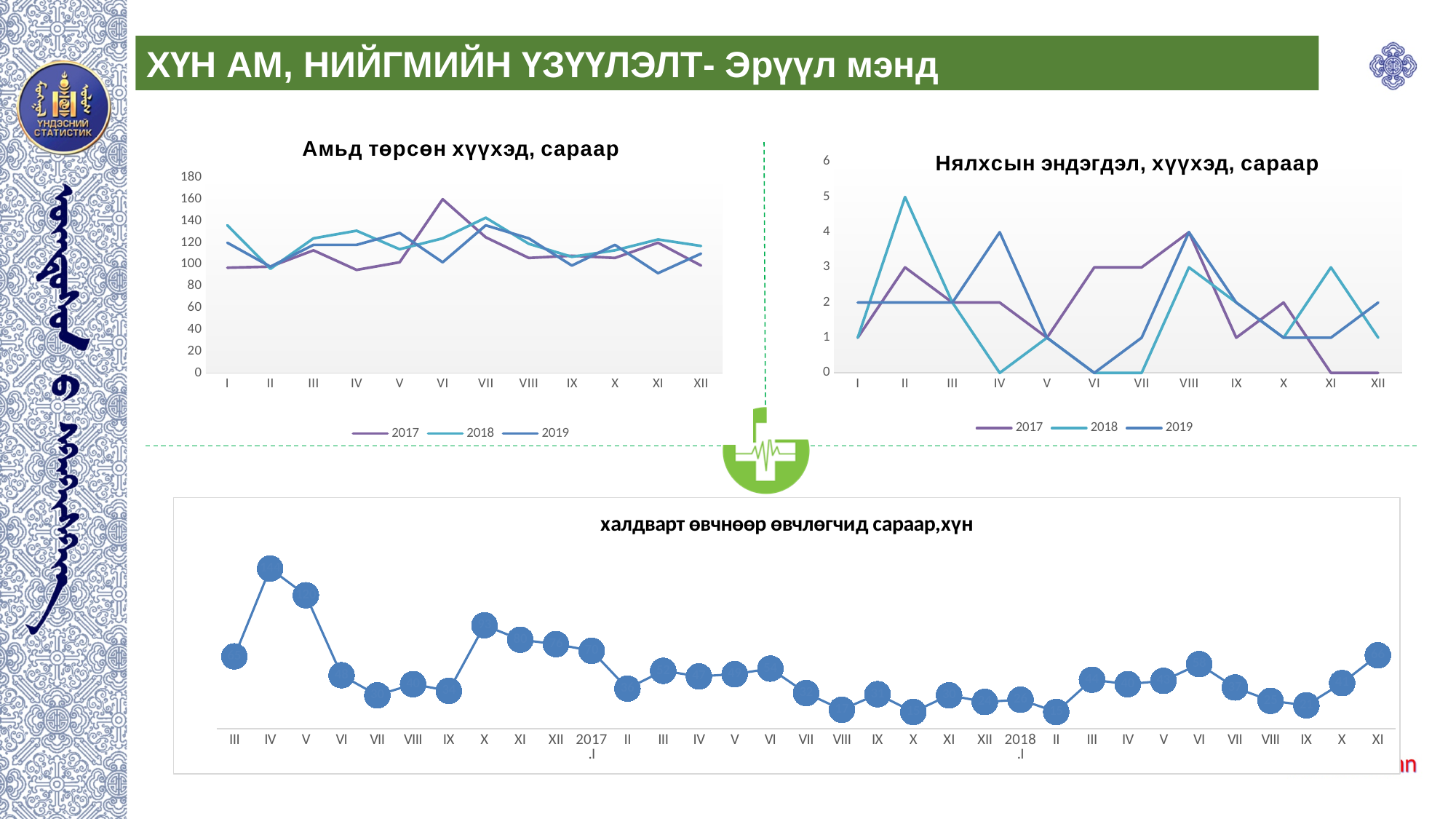
How many series does the legend of "Амьд төрсөн хүүхэд, сараар" list? 3 In "Нялхсын эндэгдэл, хүүхэд, сараар", what is the 2018 value for month II? 5 In "Амьд төрсөн хүүхэд, сараар", is the 2017 value for month VI greater or less than 140? greater How many data points are plotted in "халдварт өвчнөөр өвчлөгчид сараар,хүн"? 33 In "Нялхсын эндэгдэл, хүүхэд, сараар", what is the 2017 value for month XII? 0 In "Амьд төрсөн хүүхэд, сараар", which month has the highest 2017 value? VI In "халдварт өвчнөөр өвчлөгчид сараар,хүн", which month has the highest value? IV In "Нялхсын эндэгдэл, хүүхэд, сараар", what is the 2019 value for month IV? 4 What kind of chart is "Амьд төрсөн хүүхэд, сараар"? line chart In "Нялхсын эндэгдэл, хүүхэд, сараар", which is larger for month I: the 2017 value or the 2018 value? Neither; both are 1 In "Нялхсын эндэгдэл, хүүхэд, сараар", which month has the highest 2018 value? II In "Амьд төрсөн хүүхэд, сараар", is the 2019 value for month XI greater or less than 100? less